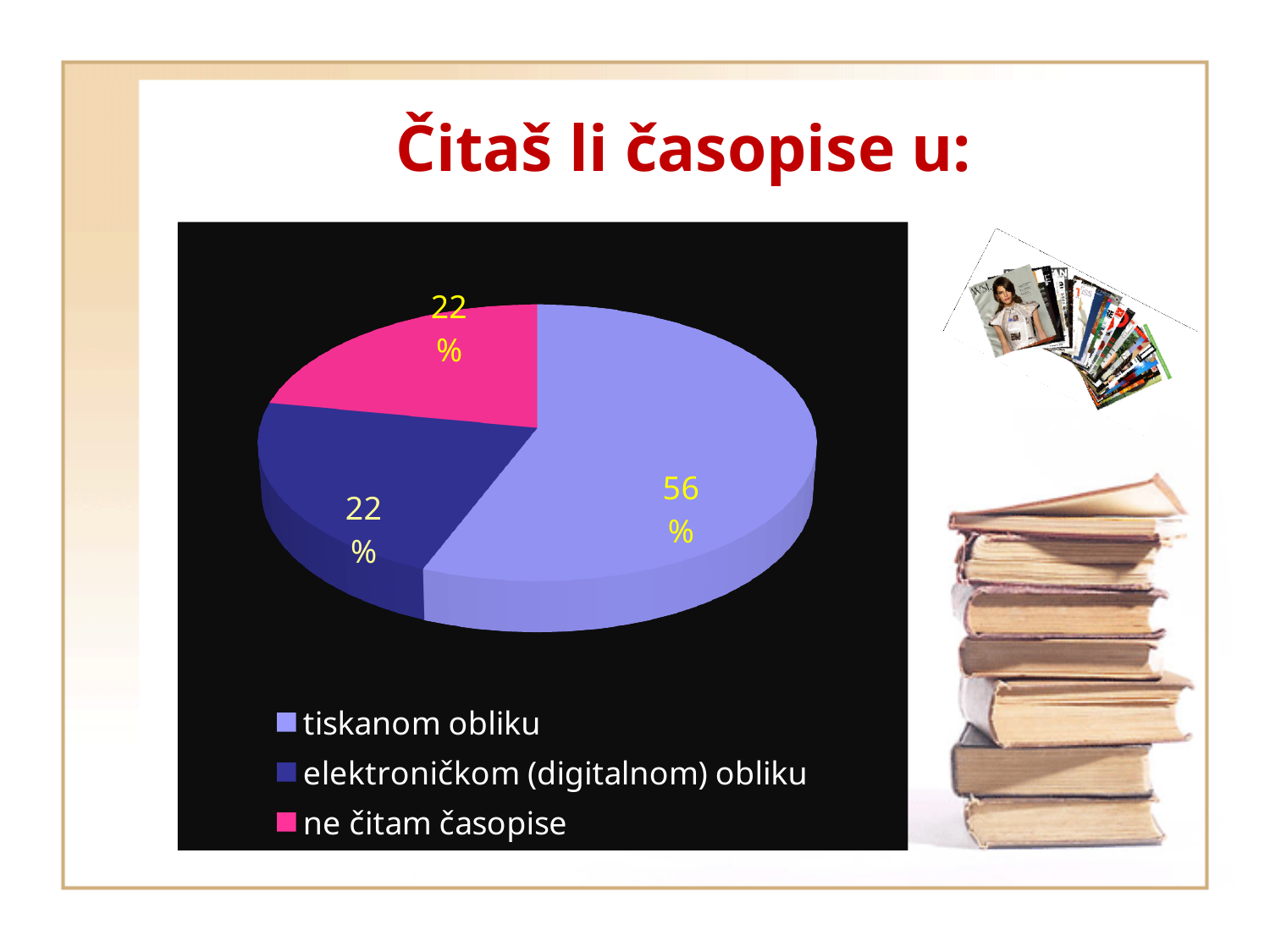
What kind of chart is shown on the slide? pie chart What is the title of the slide? Čitaš li časopise u: Which category has the largest slice of the pie? tiskanom obliku What percentage of the pie is labelled for "elektroničkom (digitalnom) obliku"? 22% What percentage of the pie is labelled for "ne čitam časopise"? 22% How many slices does the pie chart have? 3 What share of the pie does "tiskanom obliku" take? 56% What is the difference in percentage points between "tiskanom obliku" and "ne čitam časopise"? 34 Which is larger, the slice for "tiskanom obliku" or the slice for "elektroničkom (digitalnom) obliku"? tiskanom obliku How many entries does the legend list? 3 What colour is the slice for "ne čitam časopise"? pink What percentage of the pie is labelled for "tiskanom obliku"? 56%